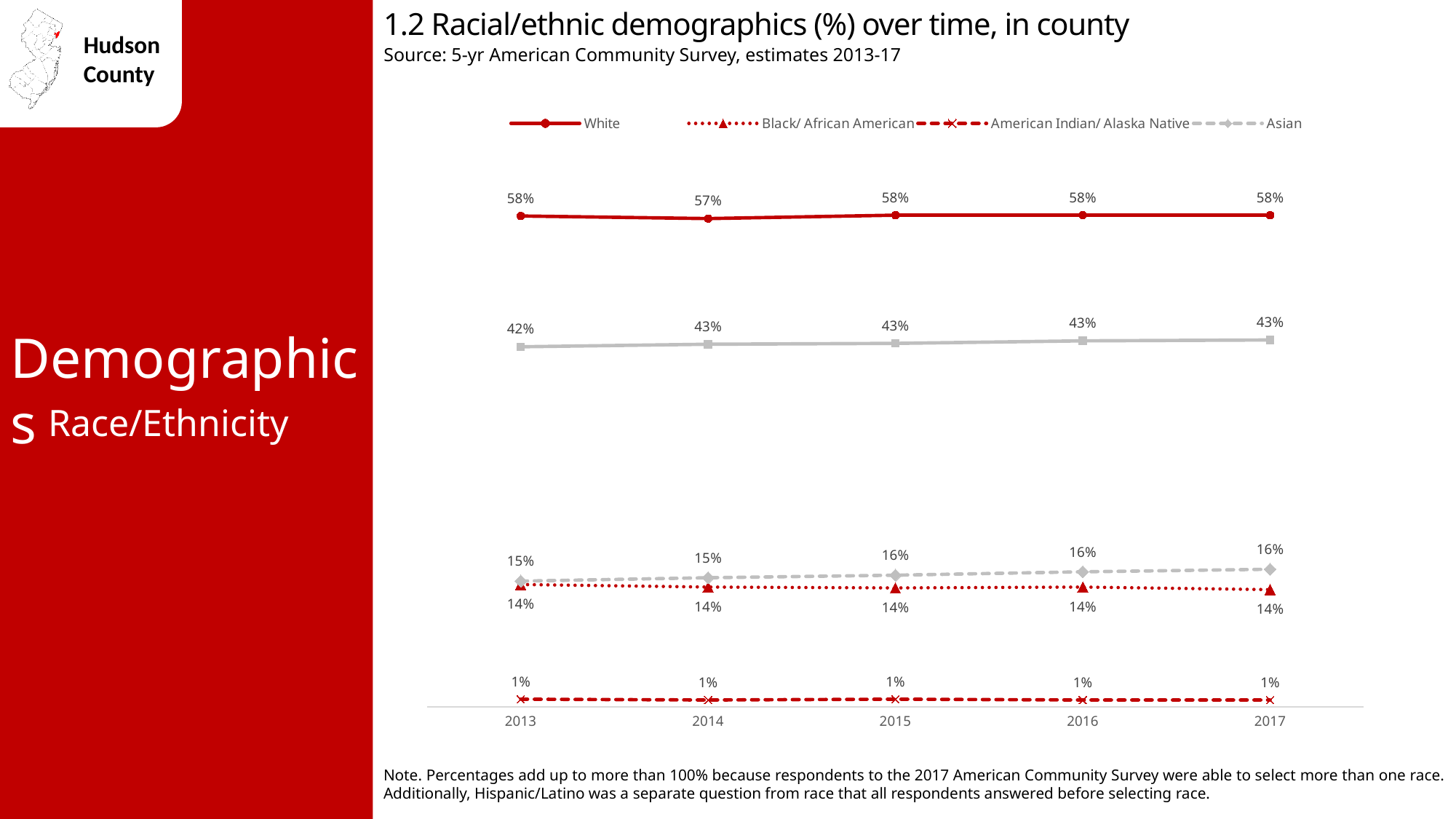
What kind of chart is shown on the slide? Line chart In 2016, which is larger: the Asian value or the Black/ African American value? Asian Which legend series has the lowest value in 2017? American Indian/ Alaska Native How many series does the legend list? 4 Does the Asian series rise or fall from 2013 to 2017? Rise What is the value for White in 2014? 57% What is the difference between the White value and the Asian value in 2017? 42 percentage points Which legend series has the highest value in 2013? White What is the value for American Indian/ Alaska Native in 2013? 1% What is the value for Black/ African American in 2015? 14% How many years are shown on the x axis? 5 What is the value for Asian in 2017? 16%